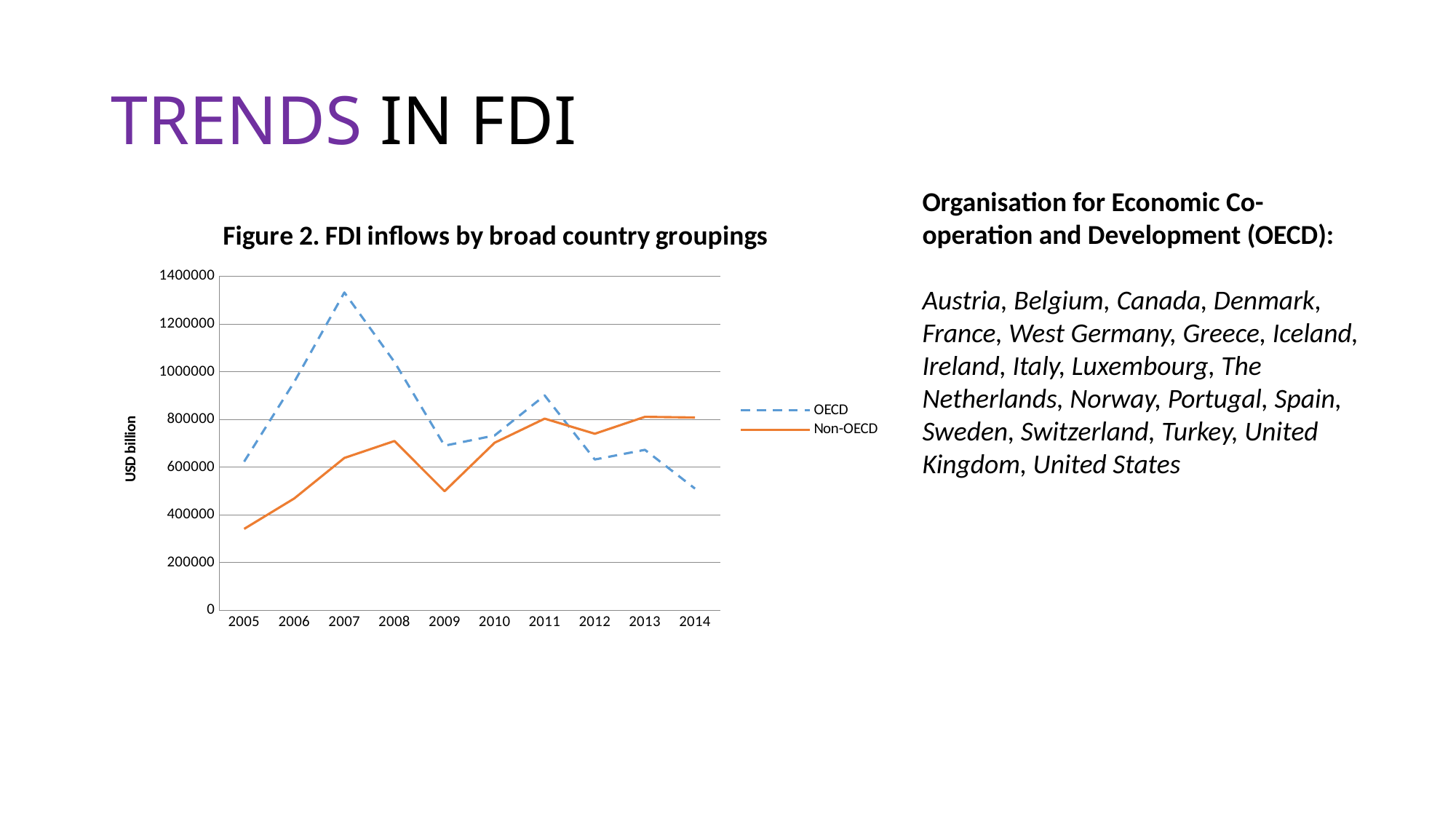
Which series has the larger value in 2013, OECD or Non-OECD? Non-OECD Which series has the larger value in 2007, OECD or Non-OECD? OECD Is the OECD value for 2007 greater or less than 1200000? greater Does the OECD series rise or fall from 2011 to 2014? fall How many series does the legend list in Figure 2? 2 Is the OECD value for 2014 greater or less than 600000? less What type of chart is shown in Figure 2? line chart What is the label on the y axis of Figure 2? USD billion In which year does the OECD series reach its highest value? 2007 Is the Non-OECD value for 2005 greater or less than 400000? less How many years are shown on the x axis of Figure 2? 10 In which year is the Non-OECD series at its lowest value? 2005